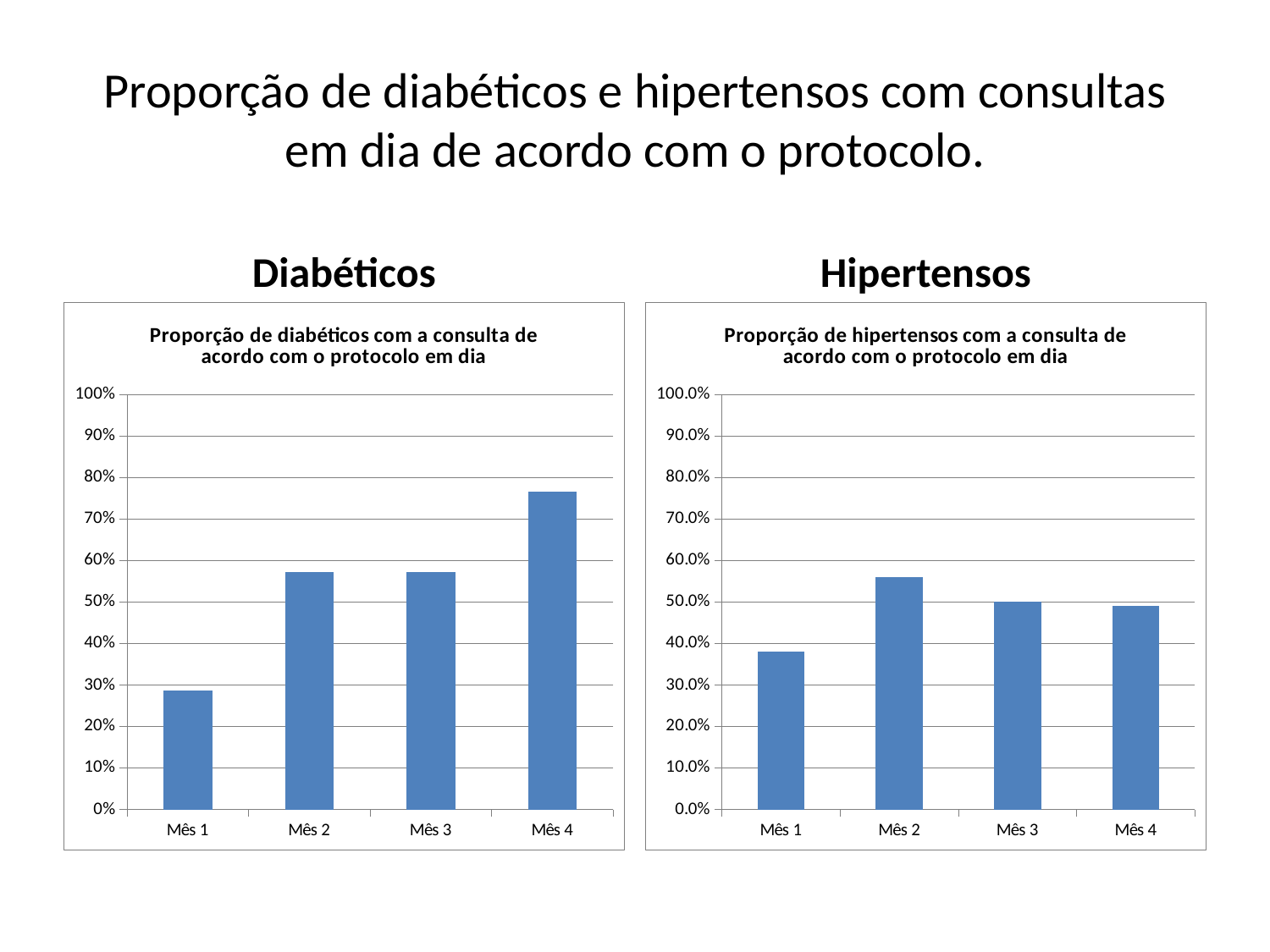
In the Diabéticos chart, is the value for Mês 4 greater or less than 70%? greater In the Diabéticos chart, which month has the lowest value? Mês 1 What kind of chart is the Diabéticos chart? Bar chart In the Diabéticos chart, which is larger, the value for Mês 1 or the value for Mês 2? Mês 2 In the Diabéticos chart, is the value for Mês 1 greater or less than 30%? less In the Hipertensos chart, which month has the lowest value? Mês 1 In the Hipertensos chart, which month has the highest value? Mês 2 How many months are shown on the x axis of the Hipertensos chart? 4 In the Diabéticos chart, which month has the highest value? Mês 4 In the Hipertensos chart, is the value for Mês 1 greater or less than 40.0%? less What is the title printed inside the Hipertensos chart? Proporção de hipertensos com a consulta de acordo com o protocolo em dia